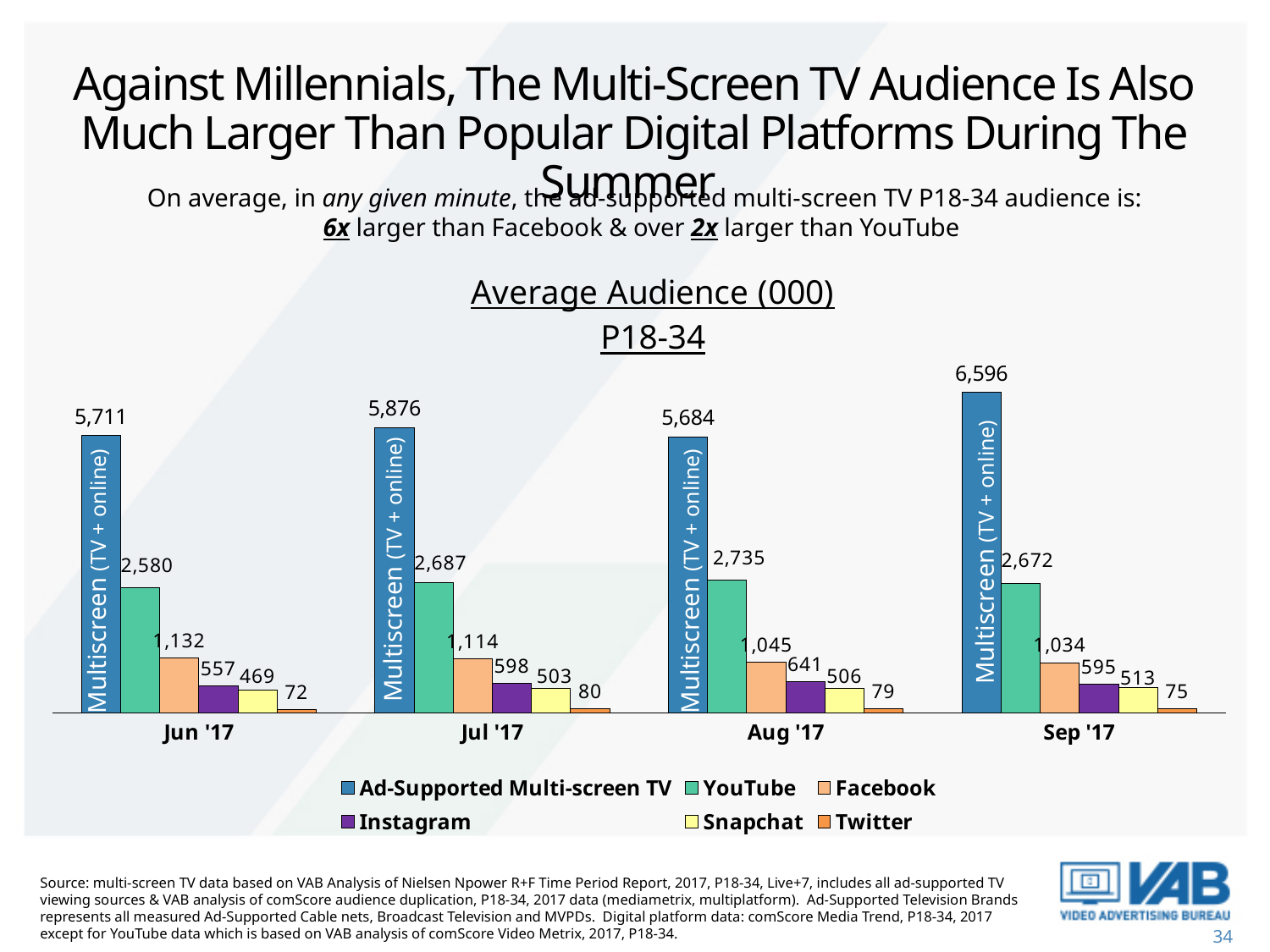
Which has a larger average audience in Aug '17, Instagram or Snapchat? Instagram What is the title of the chart? Average Audience (000) P18-34 How many months are shown on the x axis of the chart? 4 What is the difference between the Ad-Supported Multi-screen TV and YouTube average audience (000) in Jun '17? 3,131 In which month is the Ad-Supported Multi-screen TV average audience highest? Sep '17 What is the Ad-Supported Multi-screen TV average audience (000) for Sep '17? 6,596 What kind of chart is shown on the slide? Bar chart In which month is the Snapchat average audience lowest? Jun '17 What is the Facebook average audience (000) for Jun '17? 1,132 What is the Twitter average audience (000) for Jul '17? 80 What is the YouTube average audience (000) for Aug '17? 2,735 How many series does the chart legend list? 6